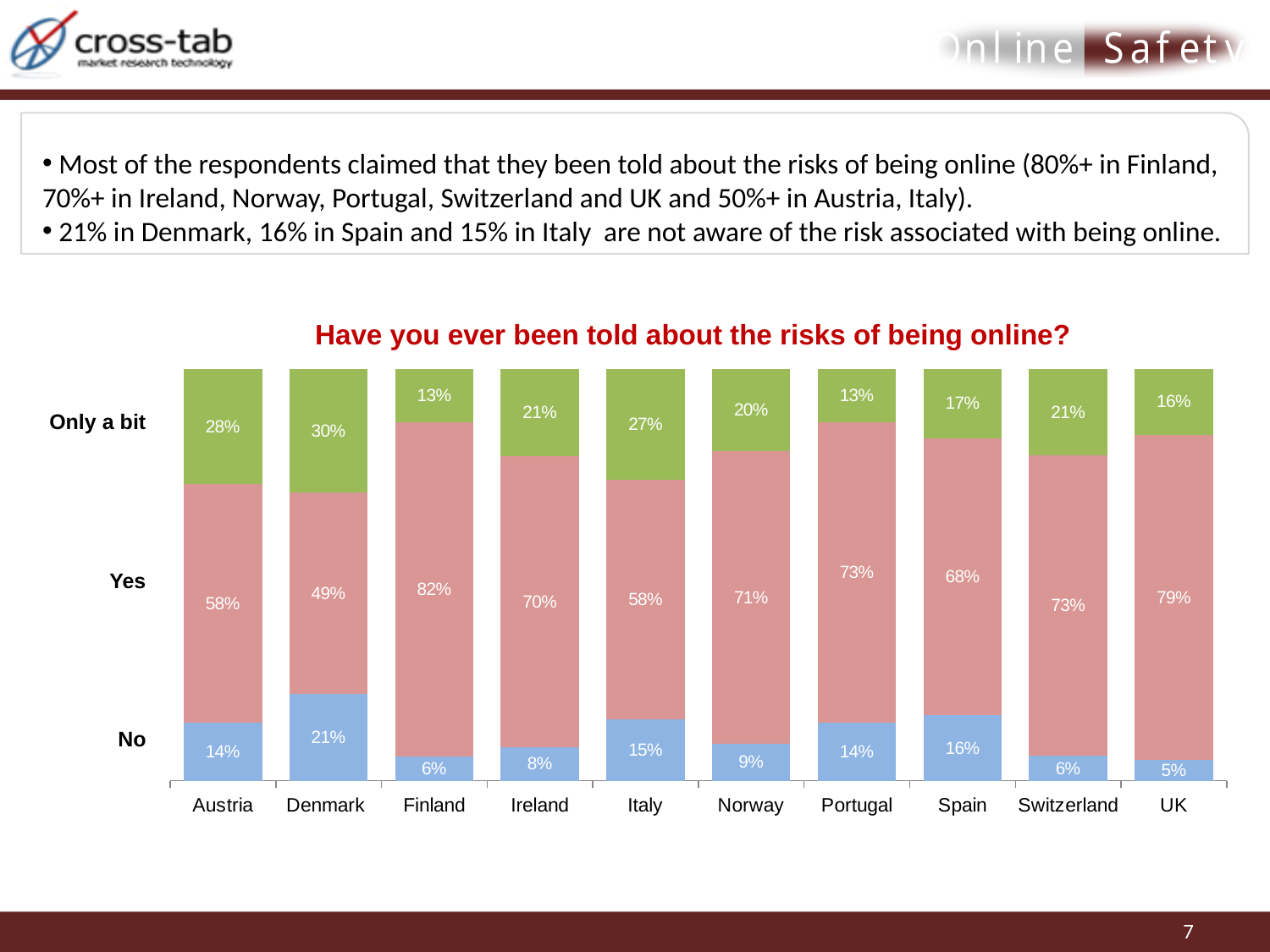
What is the difference between the 'Yes' percentages for the UK and Spain? 11% How many countries are shown on the x axis of the chart? 10 What kind of chart is shown on the slide? Stacked bar chart Which response category is shown by the green segments at the top of the bars? Only a bit Which country has the lowest 'No' percentage? UK What is the title of the chart? Have you ever been told about the risks of being online? What percentage of respondents in Denmark answered 'No'? 21% Which country has the highest 'Yes' percentage? Finland What percentage of respondents in Austria answered 'Only a bit'? 28% Which country has the highest 'Only a bit' percentage? Denmark Which is larger, the 'No' percentage for Italy or for Norway? Italy What percentage of respondents in Finland answered 'Yes'? 82%